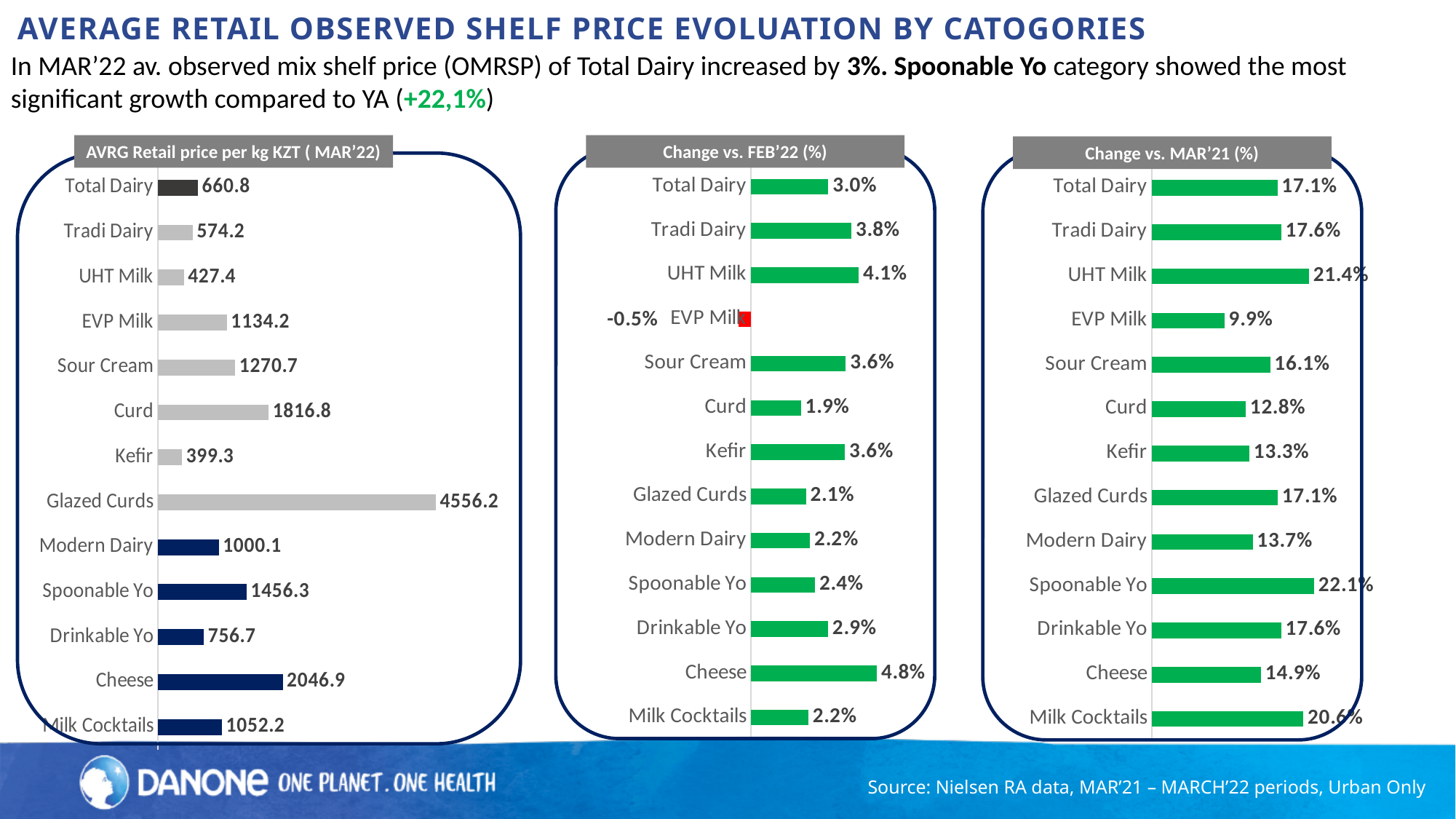
In the 'Change vs. MAR'21 (%)' chart, which category has the highest value? Spoonable Yo In the 'Change vs. MAR'21 (%)' chart, what is the value for Spoonable Yo? 22.1% In the 'AVRG Retail price per kg KZT (MAR'22)' chart, which category has the lowest price? Kefir In the 'AVRG Retail price per kg KZT (MAR'22)' chart, what is the value for Glazed Curds? 4556.2 In the 'Change vs. FEB'22 (%)' chart, which category has the lowest value? EVP Milk In the 'Change vs. FEB'22 (%)' chart, what is the value for Cheese? 4.8% How many categories are shown in the 'Change vs. MAR'21 (%)' chart? 13 What type of chart is the 'AVRG Retail price per kg KZT (MAR'22)' chart? Bar chart In the 'Change vs. MAR'21 (%)' chart, what is the difference between UHT Milk and EVP Milk? 11.5% In the 'AVRG Retail price per kg KZT (MAR'22)' chart, what is the difference between Cheese and Spoonable Yo? 590.6 In the 'Change vs. FEB'22 (%)' chart, what colour is the bar for EVP Milk? Red In the 'Change vs. FEB'22 (%)' chart, which is larger, UHT Milk or Tradi Dairy? UHT Milk